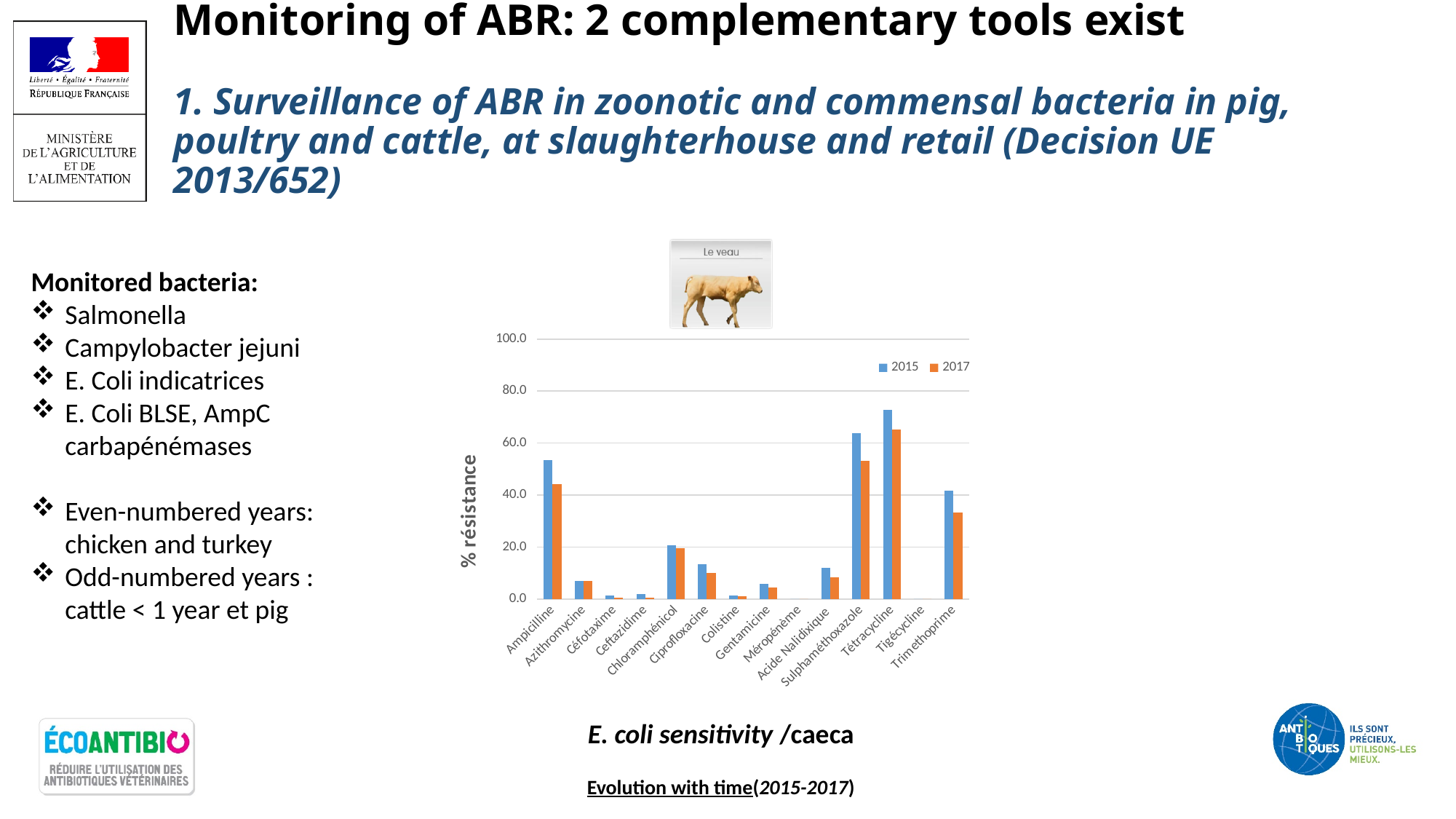
Is the 2017 value for Trimethoprime greater or less than 40.0? less Which antibiotic has the highest % résistance for 2015? Tétracycline What kind of chart is shown on the slide? bar chart How many antibiotics are shown on the x axis of the chart? 14 What is the label of the vertical axis of the chart? % résistance For 2015, which has the larger % résistance, Sulphaméthoxazole or Tétracycline? Tétracycline Is the 2015 value for Ciprofloxacine greater or less than 20.0? less How many series does the chart legend list? 2 Which antibiotic has the highest % résistance for 2017? Tétracycline Which years are listed in the chart legend? 2015 and 2017 Is the 2015 value for Tétracycline greater or less than 60.0? greater For Ampicilline, which year has the larger % résistance, 2015 or 2017? 2015